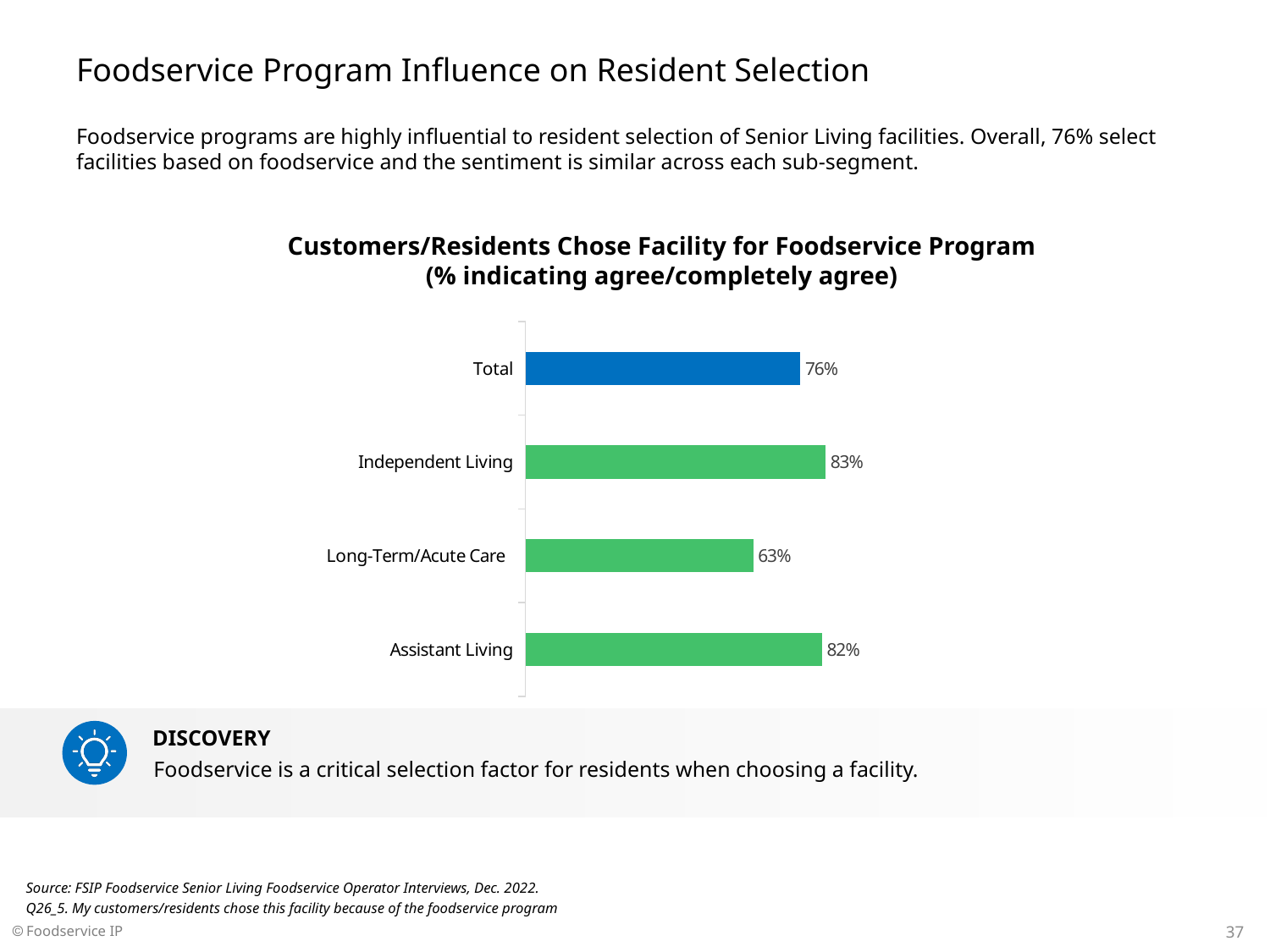
What is the value for Long-Term/Acute Care? 63% What is the value for Total? 76% What is the difference between the values for Independent Living and Long-Term/Acute Care? 20% What kind of chart is shown on the slide? Bar chart Which is larger, the value for Total or the value for Long-Term/Acute Care? Total Which bar is shown in a different colour (blue) from the others? Total What is the value for Independent Living? 83% How many categories are shown in the chart? 4 What is the difference between the values for Assistant Living and Total? 6% Which category has the highest value? Independent Living Which category has the lowest value? Long-Term/Acute Care What is the value for Assistant Living? 82%